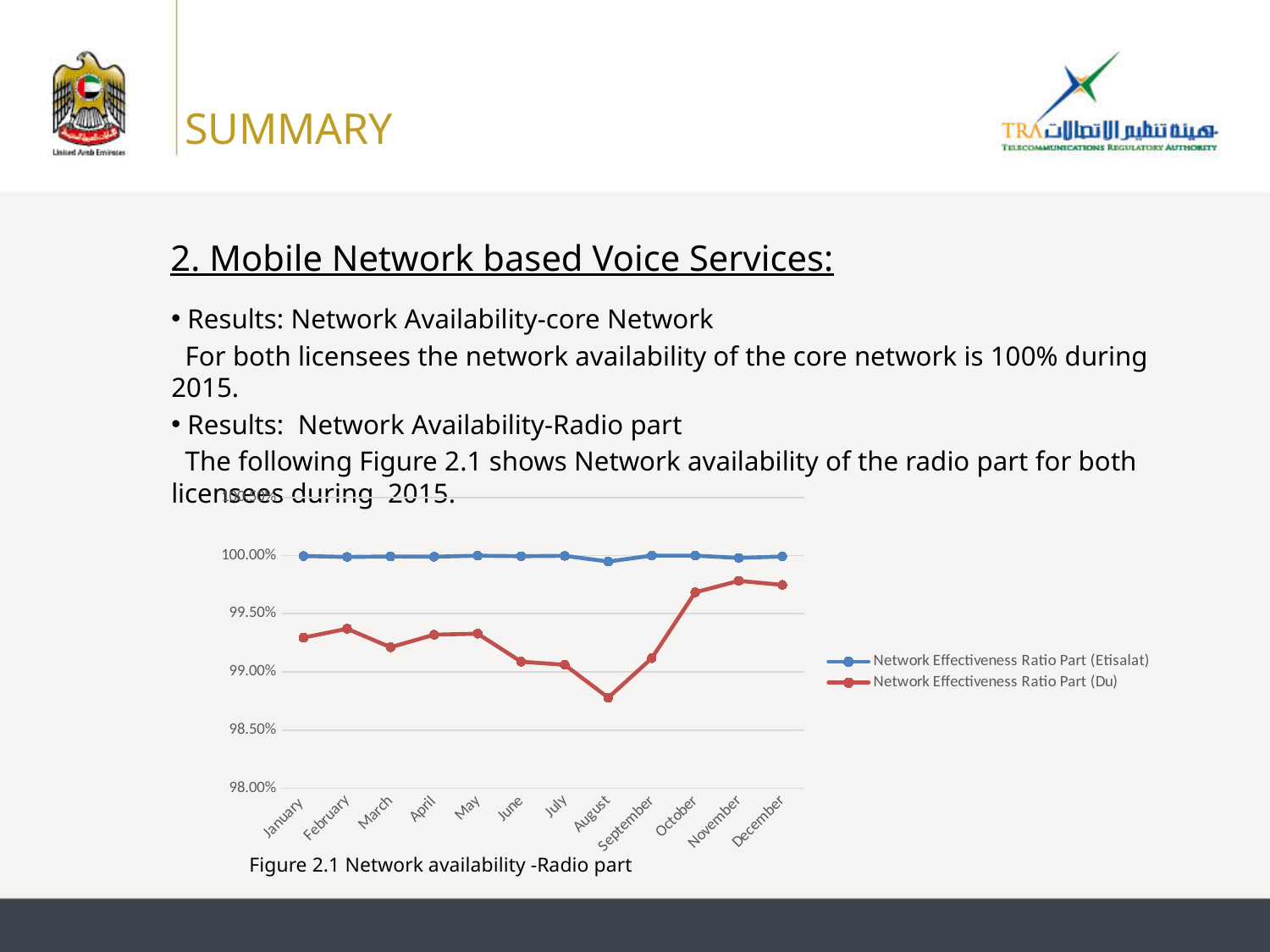
Is the value for Network Effectiveness Ratio Part (Du) in October greater or less than 99.50%? greater Which colour is used for the Network Effectiveness Ratio Part (Du) line? red What is the caption of the chart on the slide? Figure 2.1 Network availability -Radio part Does the value for Network Effectiveness Ratio Part (Du) rise or fall from August to November? rise What kind of chart is shown in Figure 2.1? line chart How many months are plotted along the x axis of the chart? 12 How many series does the legend of the chart list? 2 Is the value for Network Effectiveness Ratio Part (Du) in August greater or less than 99.00%? less In August, which series has the larger value, Etisalat or Du? Etisalat In which month is the value for Network Effectiveness Ratio Part (Du) highest? November In which month is the value for Network Effectiveness Ratio Part (Du) lowest? August Is the value for Network Effectiveness Ratio Part (Etisalat) in August greater or less than 99.50%? greater